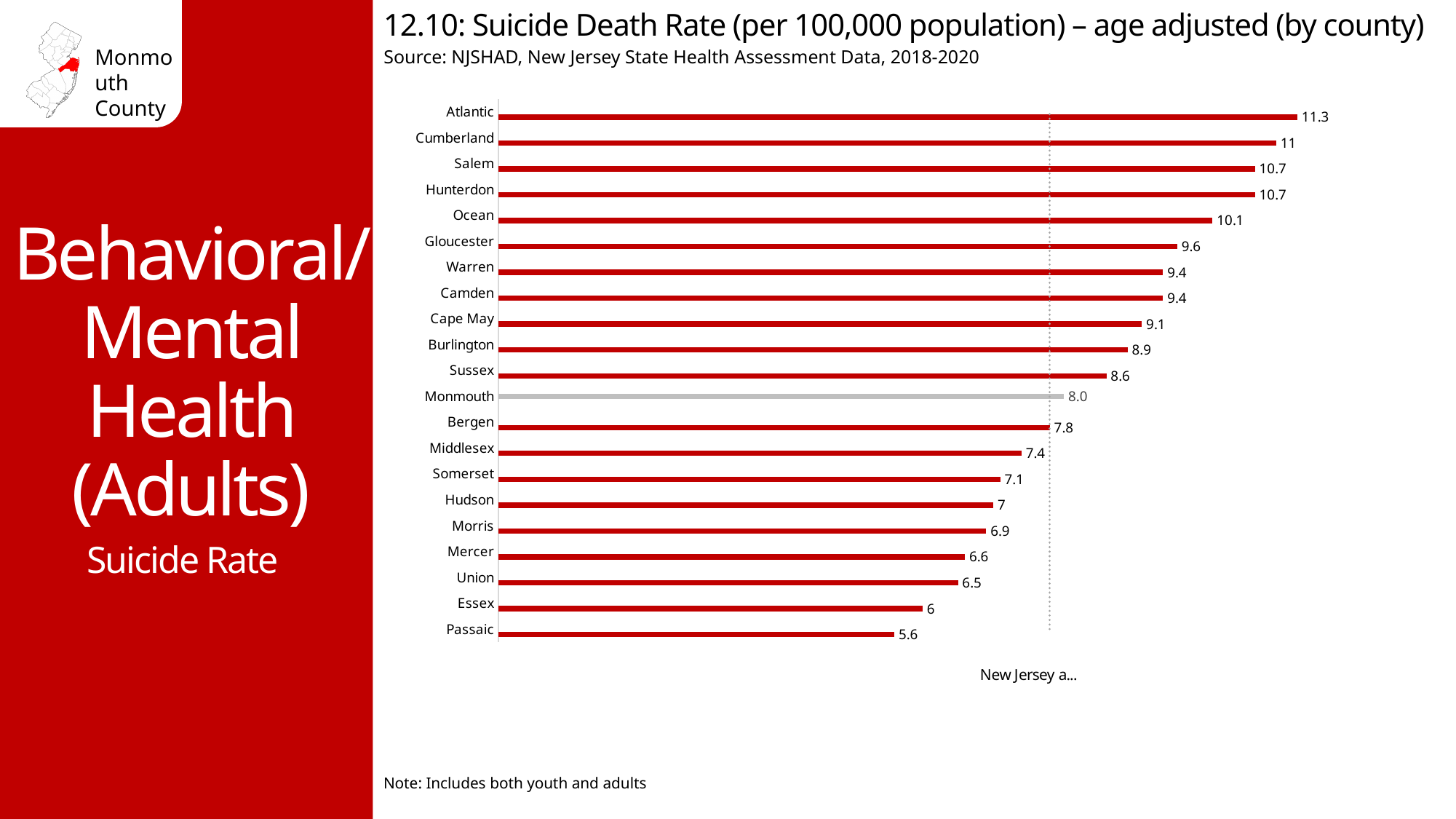
Which county has the highest suicide death rate? Atlantic What is the suicide death rate for Atlantic County? 11.3 Which county has the lowest suicide death rate? Passaic How many counties are shown in the chart? 21 Which county has a higher suicide death rate, Essex or Union? Union What is the difference between the suicide death rates of Atlantic and Passaic counties? 5.7 Which county's bar is shown in grey rather than red? Monmouth What kind of chart is shown on the slide? Bar chart What is the suicide death rate for Monmouth County? 8.0 Which county has a higher suicide death rate, Ocean or Gloucester? Ocean What is the difference between the suicide death rates of Monmouth and Bergen counties? 0.2 What is the suicide death rate for Passaic County? 5.6